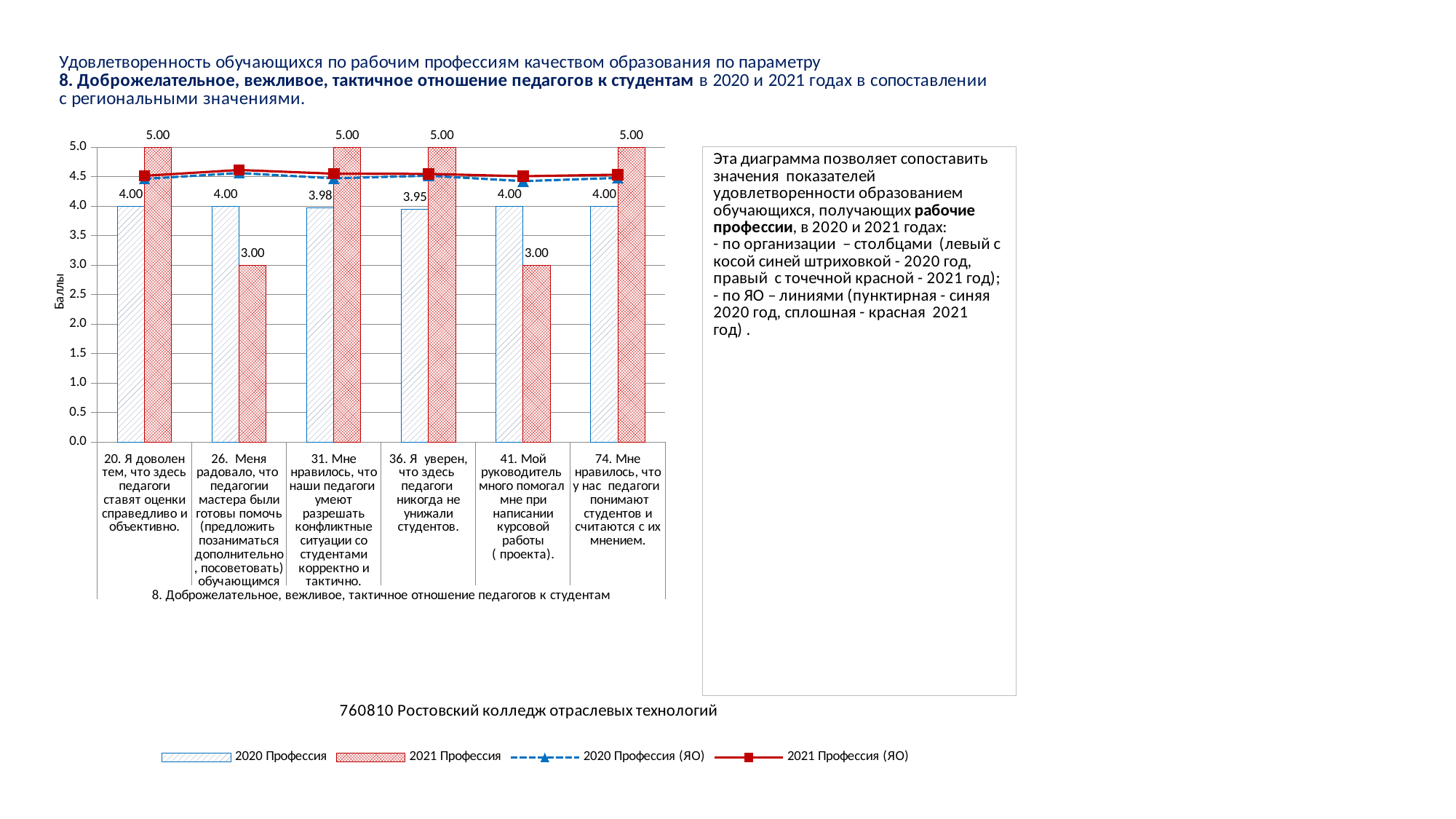
For category "41. Мой руководитель много помогал мне при написании курсовой работы (проекта).", how much higher is the 2020 Профессия bar than the 2021 Профессия bar? 1.00 What is the value of the 2020 Профессия bar for category "31. Мне нравилось, что наши педагоги умеют разрешать конфликтные ситуации..."? 3.98 What is the difference between the 2021 Профессия and 2020 Профессия bars for category "20. Я доволен тем, что здесь педагоги ставят оценки справедливо и объективно."? 1.00 What is the value of the 2021 Профессия bar for category "26. Меня радовало, что педагоги мастера были готовы помочь..."? 3.00 What is the title of the vertical axis of the chart? Баллы For category "26. Меня радовало, что педагоги мастера были готовы помочь...", which bar is larger: 2020 Профессия or 2021 Профессия? 2020 Профессия What is the value of the 2020 Профессия bar for category "36. Я уверен, что здесь педагоги никогда не унижали студентов."? 3.95 Is the value of the 2021 Профессия (ЯО) line for category "26. Меня радовало, что педагоги мастера были готовы помочь..." greater or less than 4.5? greater What kind of chart is shown on the slide? bar and line chart Which category has the lowest 2020 Профессия bar? 36. Я уверен, что здесь педагоги никогда не унижали студентов. How many series does the chart legend list? 4 How many categories are shown on the x axis of the chart? 6